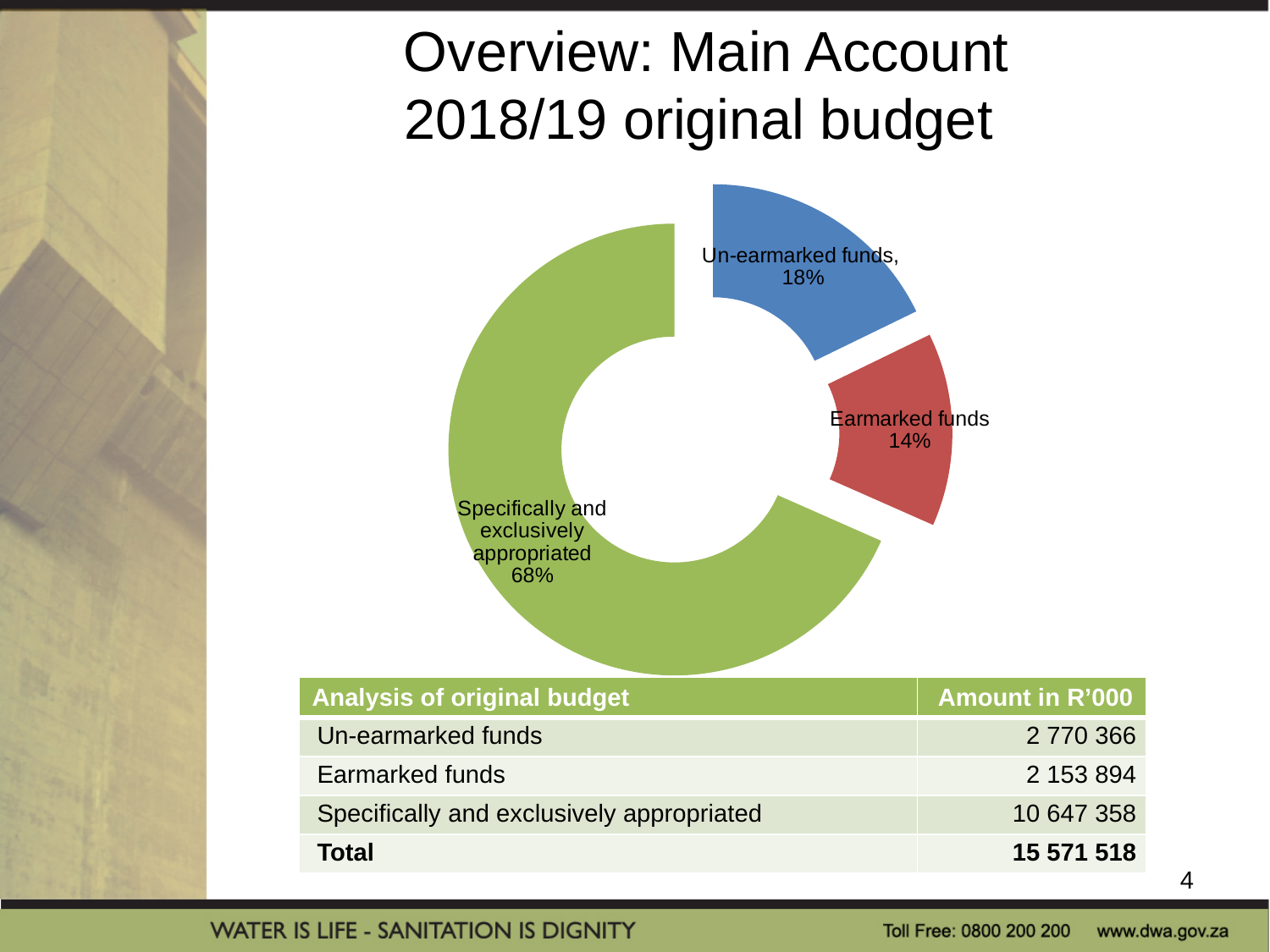
What percentage is shown for Specifically and exclusively appropriated in the chart? 68% What is the difference in percentage points between the Un-earmarked funds slice and the Earmarked funds slice? 4 percentage points What is the difference in percentage points between the Specifically and exclusively appropriated slice and the Un-earmarked funds slice? 50 percentage points Which category has the smallest slice in the chart? Earmarked funds What kind of chart is shown on the slide? Doughnut (pie) chart How many categories are shown in the chart? 3 Which category has the largest slice in the chart? Specifically and exclusively appropriated What colour is the Earmarked funds slice in the chart? Red What share of the chart does Earmarked funds represent? 14% What colour is the Specifically and exclusively appropriated slice in the chart? Green What share of the 2018/19 original budget is shown for Un-earmarked funds in the chart? 18% Which is larger in the chart, Un-earmarked funds or Earmarked funds? Un-earmarked funds